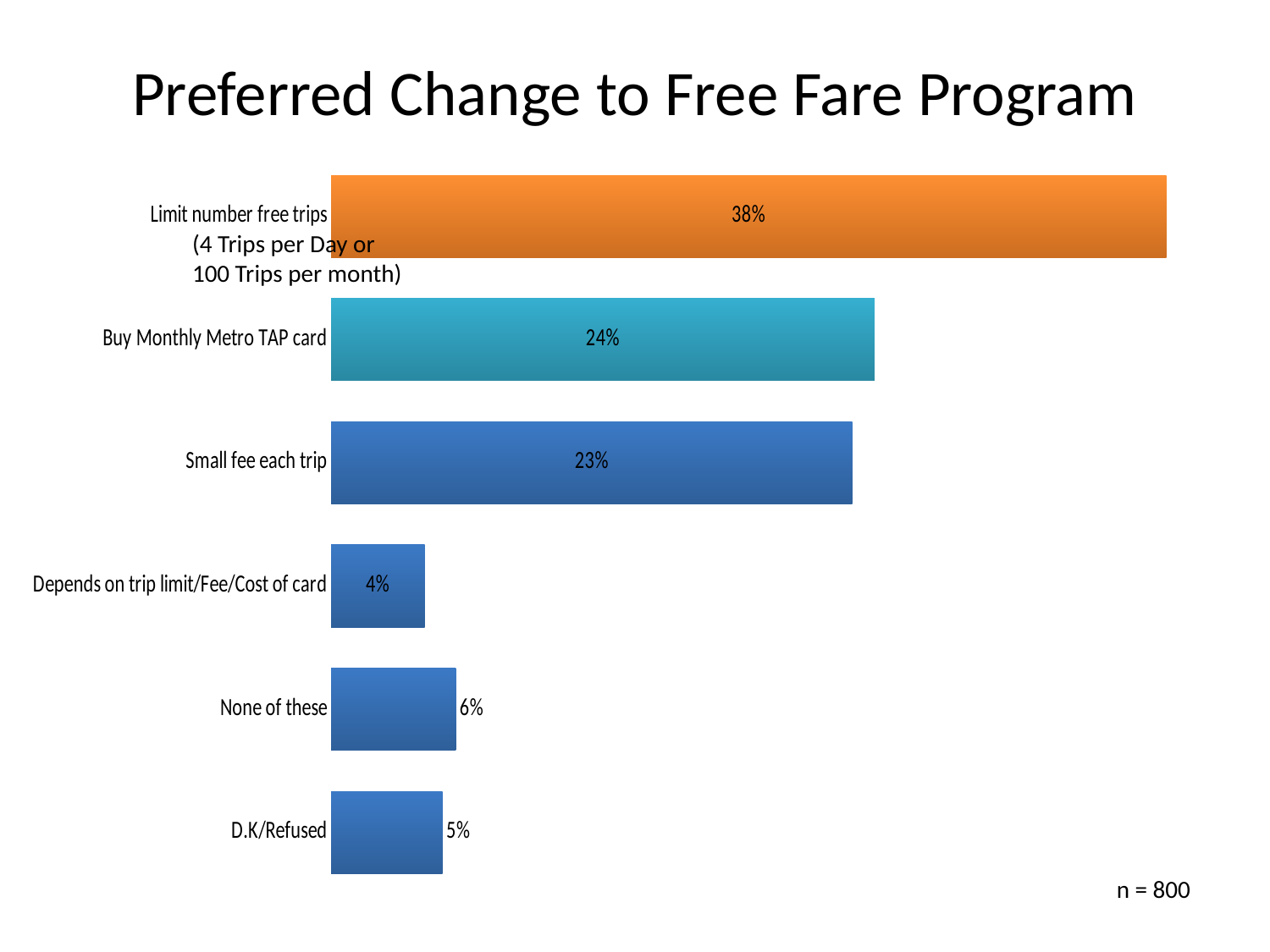
What is the difference between 'Limit number free trips' and 'Buy Monthly Metro TAP card'? 14% What percentage answered 'None of these'? 6% Which is larger: 'None of these' or 'D.K/Refused'? None of these What is the value for 'Small fee each trip'? 23% How many categories are shown in the chart? 6 What kind of chart is shown on the slide? Bar chart Which category has the highest value? Limit number free trips What is the value for 'D.K/Refused'? 5% What is the title of the chart? Preferred Change to Free Fare Program Which category has the lowest value? Depends on trip limit/Fee/Cost of card What is the value for 'Buy Monthly Metro TAP card'? 24% What percentage of respondents preferred to limit the number of free trips? 38%